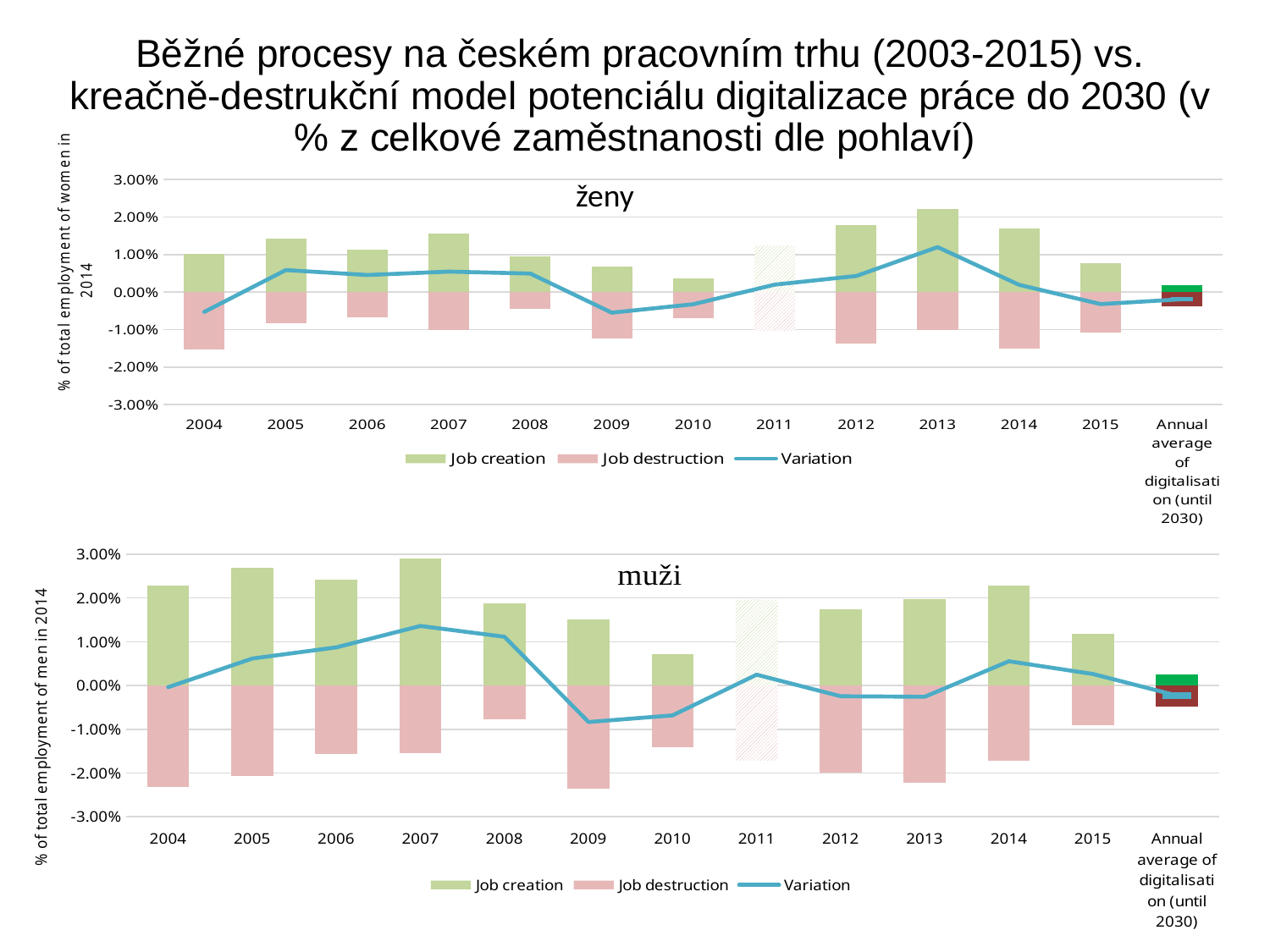
In the top chart (ženy), which year has the highest Job creation bar? 2013 In the top chart (ženy), is the Job creation value for 2010 greater or less than 1.00%? less What kind of chart is the bottom chart (muži)? bar chart with a line In the bottom chart (muži), is the Job destruction value for 2004 greater or less than -2.00%? less How many series does the legend list in the top chart (ženy)? 3 In the bottom chart (muži), which year has the lowest Job creation bar among 2004-2015? 2010 In the bottom chart (muži), does the Variation line rise or fall from 2007 to 2009? fall In the top chart (ženy), is the Job creation value for 2013 greater or less than 2.00%? greater What are the three legend entries in the bottom chart (muži)? Job creation, Job destruction, Variation In the top chart (ženy), which is larger, the Job creation value for 2007 or for 2008? 2007 In the bottom chart (muži), which year has the highest Job creation bar? 2007 In the top chart (ženy), how many categories are shown on the x axis? 13